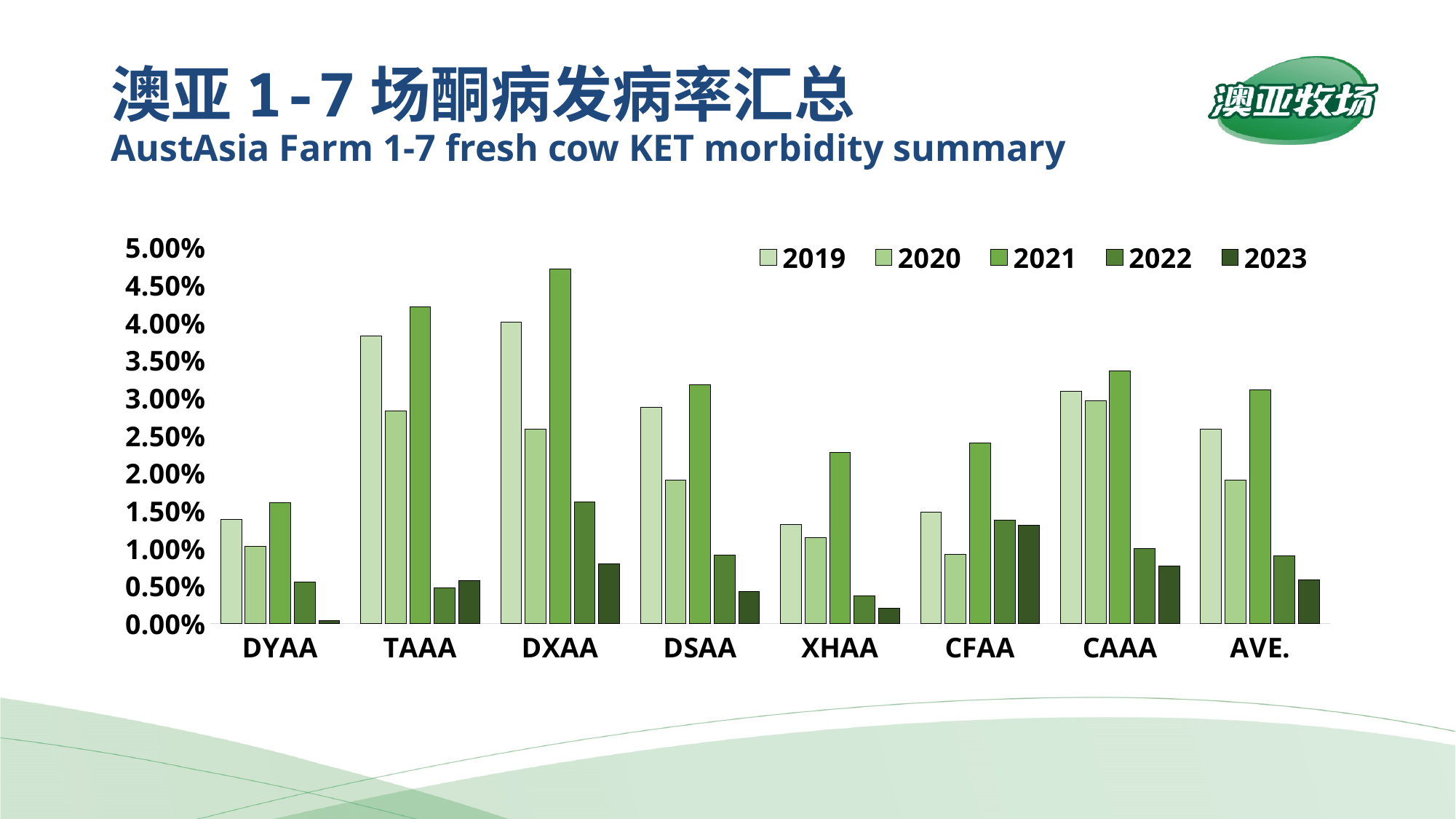
Which category has the highest value for the 2021 series? DXAA How many series does the legend list? 5 Is the 2019 value for TAAA greater or less than 3.50%? greater How many farm categories are shown along the x axis? 8 From 2021 to 2023, do the values for AVE. rise or fall? fall Is the 2023 value for DYAA greater or less than 0.50%? less Which category has the lowest value for the 2023 series? DYAA Is the 2021 value for DXAA greater or less than 4.50%? greater Which category has the lowest value for the 2021 series? DYAA What kind of chart is shown on the slide? Bar chart Which category has the highest value for the 2023 series? CFAA Which is larger, the 2021 value for TAAA or the 2021 value for DSAA? TAAA